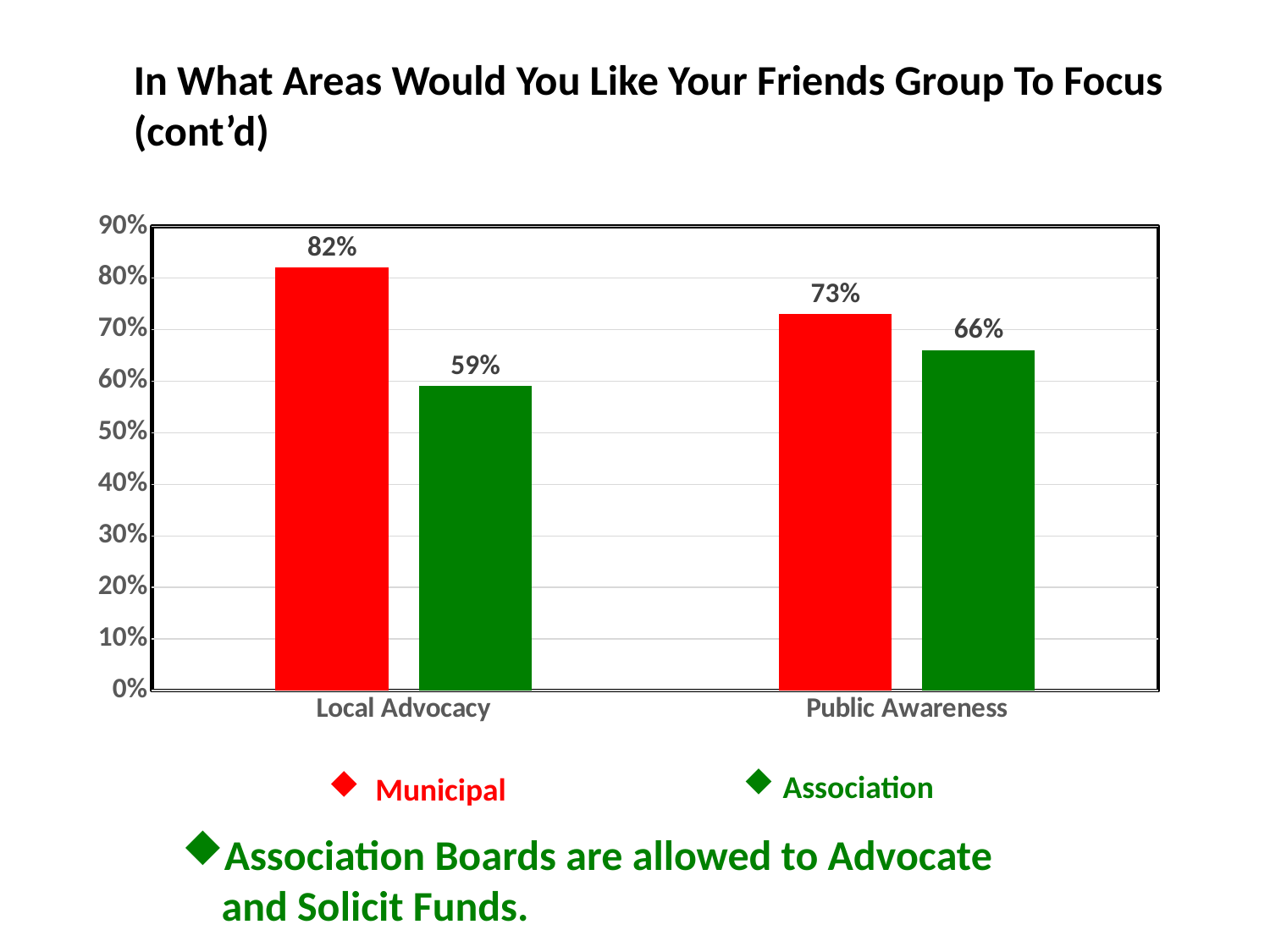
How many series does the legend list? 2 Which bar has the lowest value on the chart? Association, Local Advocacy Which is larger for Public Awareness, Municipal or Association? Municipal What is the Association value for Public Awareness? 66% How many categories are shown on the x axis? 2 Which bar has the highest value on the chart? Municipal, Local Advocacy What is the Association value for Local Advocacy? 59% What is the Municipal value for Local Advocacy? 82% What is the difference between the Municipal and Association values for Local Advocacy? 23% What is the difference between the Municipal and Association values for Public Awareness? 7% What is the Municipal value for Public Awareness? 73% What kind of chart is shown on the slide? Bar chart